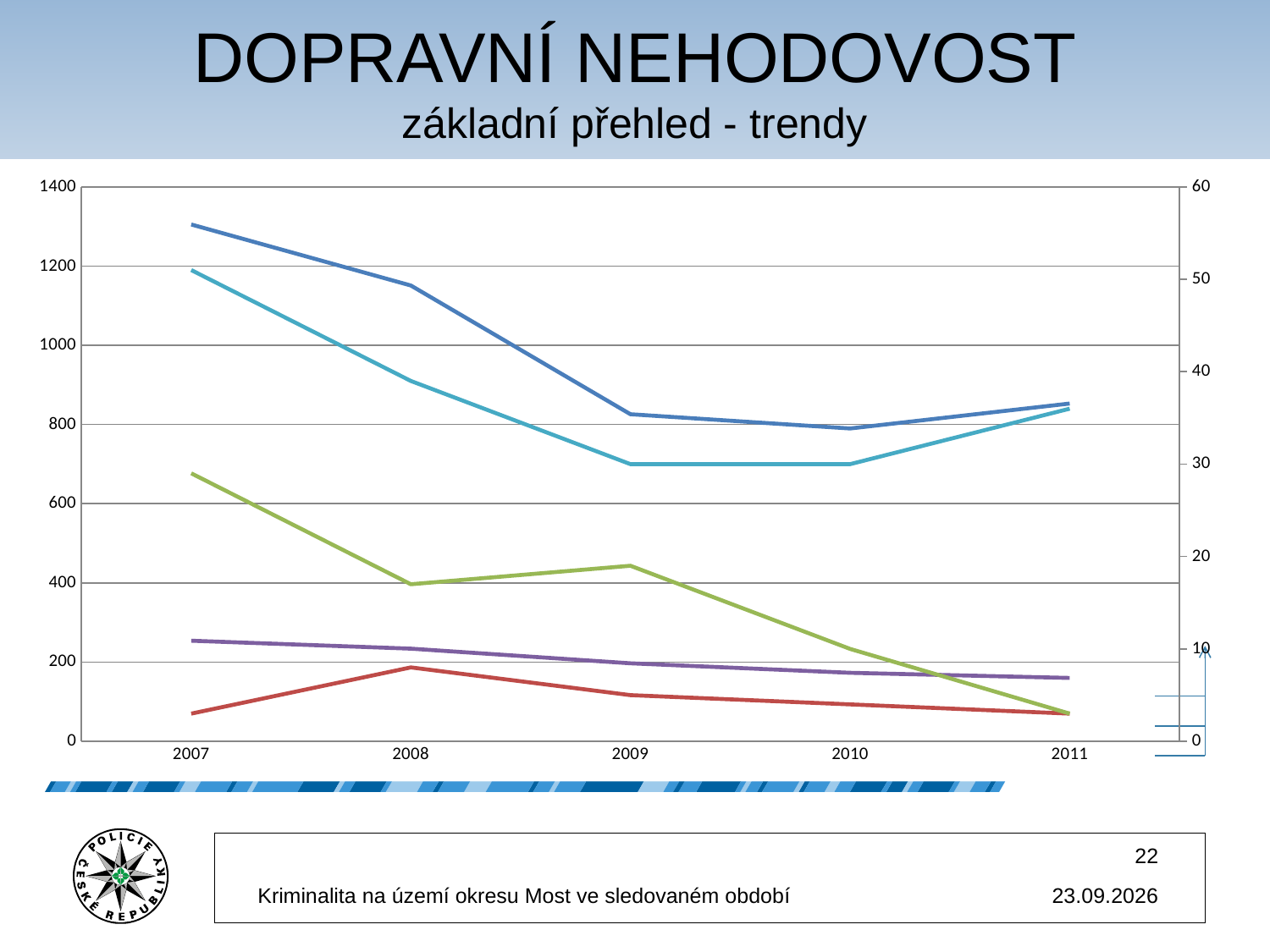
Is the value of the topmost line in 2007 greater or less than 1200 on the left axis? greater What is the last year shown on the x axis? 2011 How many years are shown along the x axis of the chart? 5 What is the highest value shown on the left vertical axis? 1400 What kind of chart is shown on the slide? line chart Is the value of the topmost line in 2011 greater or less than 1000 on the left axis? less What is the first year shown on the x axis? 2007 Is the value of the lowest line in 2007 greater or less than 200 on the left axis? less Do the two highest lines rise or fall from 2010 to 2011? rise How many lines are plotted on the chart? 5 What is the title of the chart slide? DOPRAVNÍ NEHODOVOST základní přehled - trendy Does the topmost line rise or fall from 2007 to 2009? fall